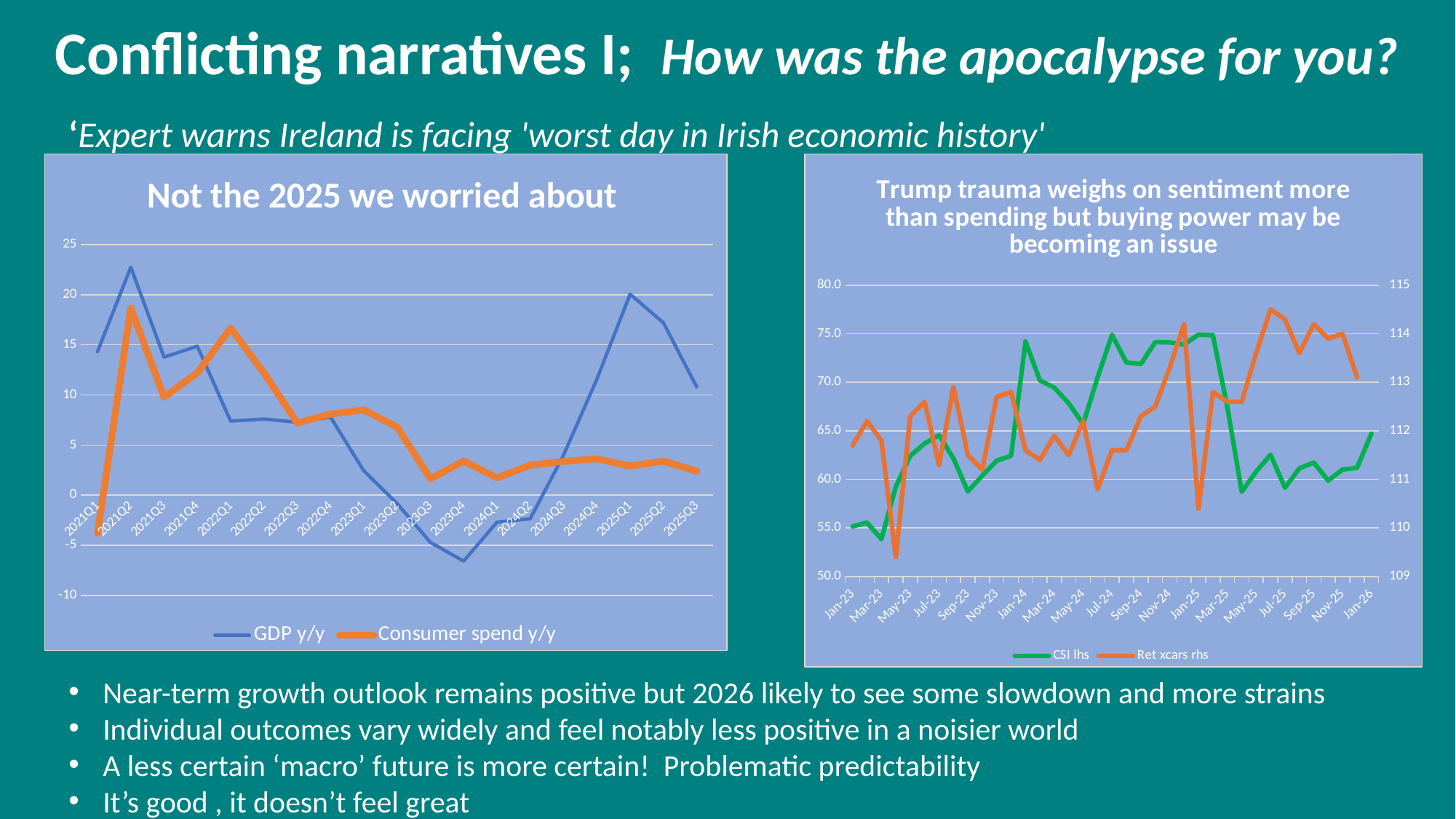
In 'Not the 2025 we worried about', is Consumer spend y/y for 2025Q3 greater or less than 5? less In 'Not the 2025 we worried about', which is larger in 2025Q1: GDP y/y or Consumer spend y/y? GDP y/y What type of chart is 'Not the 2025 we worried about'? Line chart How many series does the legend of 'Not the 2025 we worried about' list? 2 In 'Not the 2025 we worried about', in which quarter is GDP y/y highest? 2021Q2 In 'Not the 2025 we worried about', in which quarter is GDP y/y lowest? 2023Q4 How many series does the legend of the right-hand chart ('Trump trauma weighs on sentiment...') list? 2 How many quarters are shown on the x axis of 'Not the 2025 we worried about'? 19 In 'Not the 2025 we worried about', is GDP y/y for 2021Q2 greater or less than 20? greater In the right-hand chart ('Trump trauma weighs on sentiment...'), is the CSI lhs value for Jul-24 greater or less than 70? greater In 'Not the 2025 we worried about', which series is drawn in orange? Consumer spend y/y In 'Not the 2025 we worried about', does GDP y/y rise or fall from 2025Q1 to 2025Q3? Fall